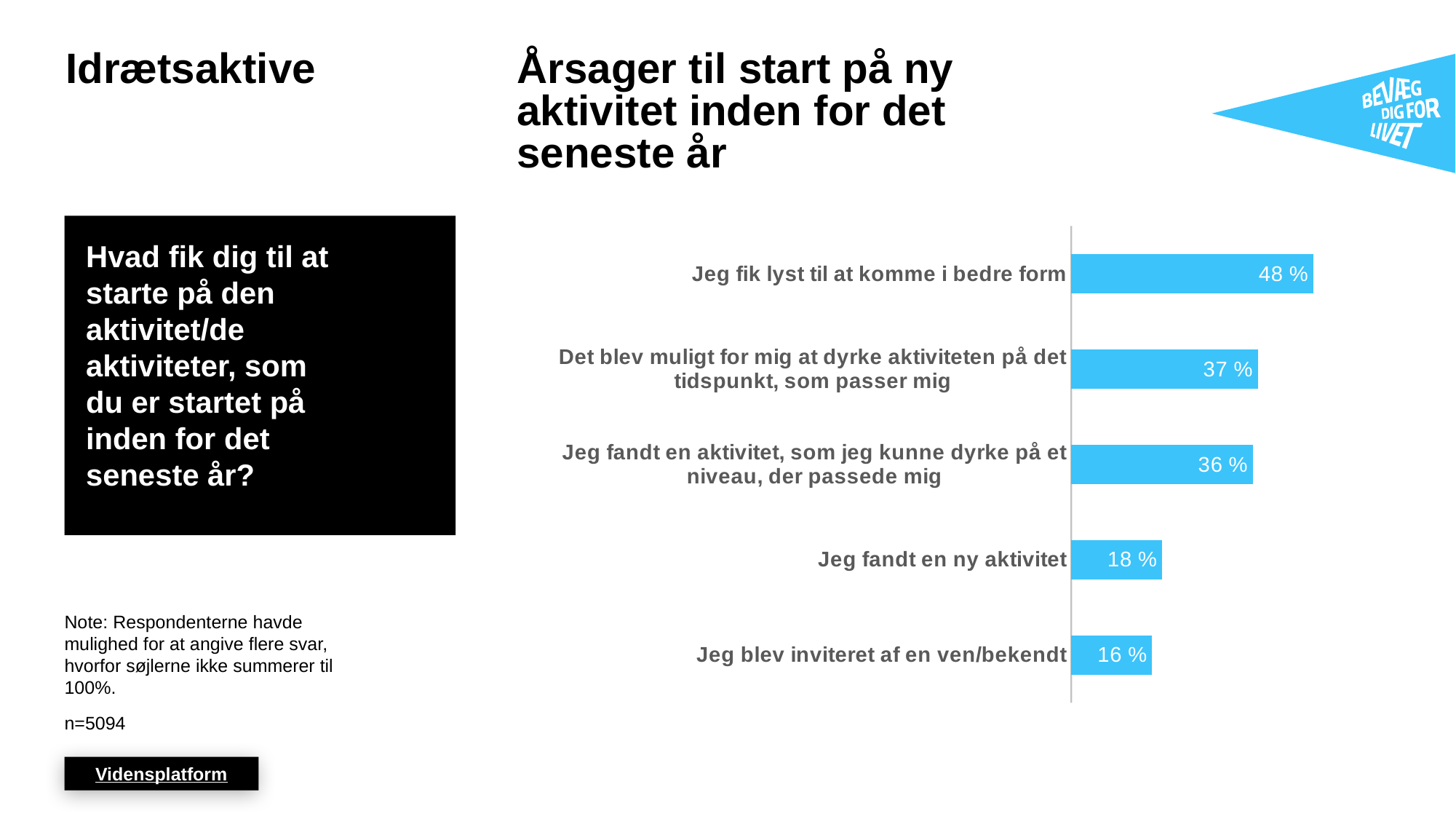
Which reason has the lowest percentage? Jeg blev inviteret af en ven/bekendt What is the difference between 'Jeg fik lyst til at komme i bedre form' and 'Jeg fandt en ny aktivitet'? 30 % What is the difference between 'Det blev muligt for mig at dyrke aktiviteten på det tidspunkt, som passer mig' and 'Jeg fandt en aktivitet, som jeg kunne dyrke på et niveau, der passede mig'? 1 % What is the value for 'Det blev muligt for mig at dyrke aktiviteten på det tidspunkt, som passer mig'? 37 % Which is larger: 'Jeg fandt en ny aktivitet' or 'Jeg blev inviteret af en ven/bekendt'? Jeg fandt en ny aktivitet What is the value for 'Jeg blev inviteret af en ven/bekendt'? 16 % What is the value for 'Jeg fandt en ny aktivitet'? 18 % How many reasons (categories) are shown in the chart? 5 What is the title of the chart? Årsager til start på ny aktivitet inden for det seneste år What type of chart is shown on the slide? Bar chart What percentage of respondents said 'Jeg fik lyst til at komme i bedre form'? 48 % Which reason has the highest percentage? Jeg fik lyst til at komme i bedre form